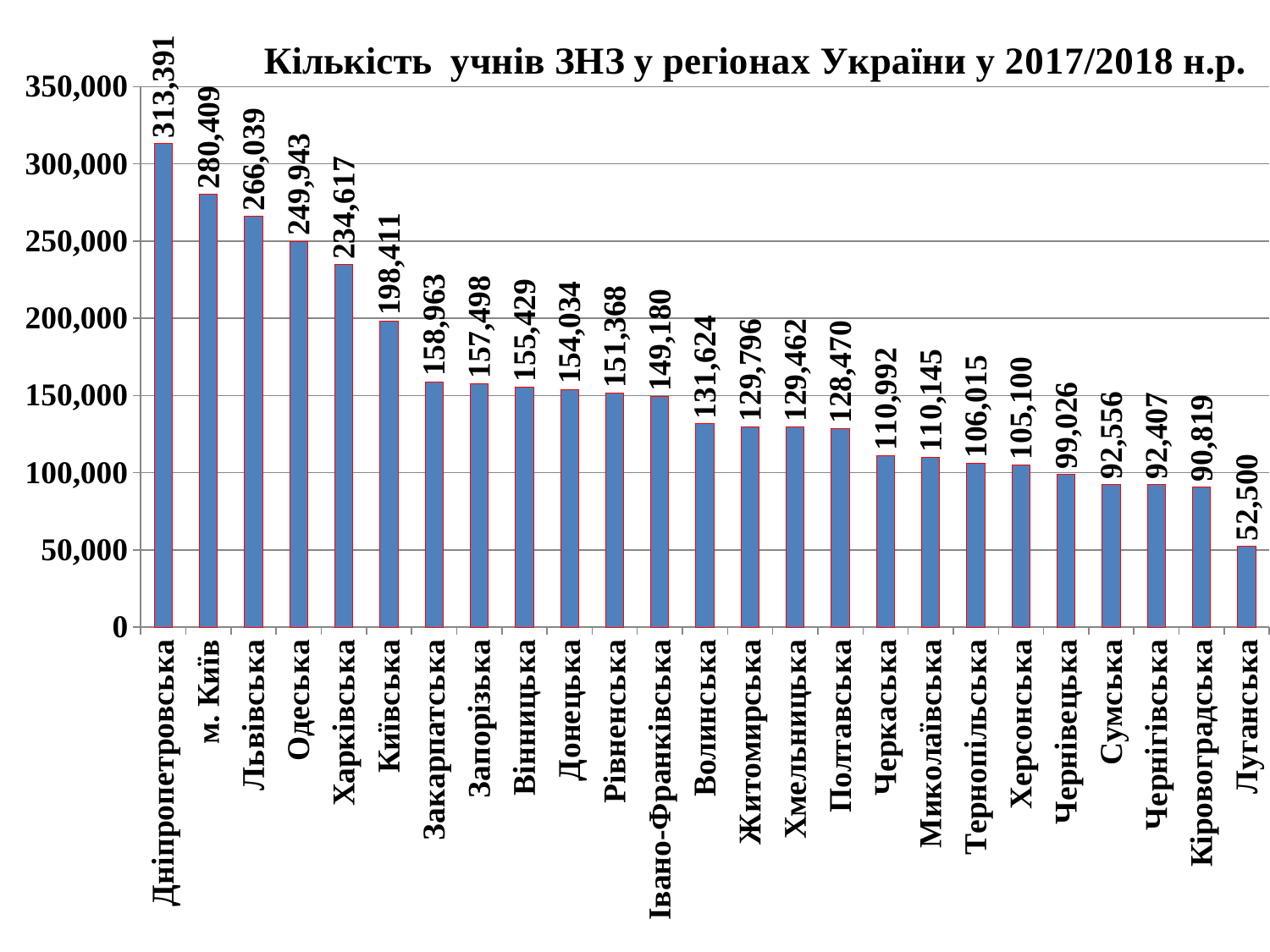
How many regions are shown on the chart? 25 Do the values rise or fall from left to right along the x axis? Fall What is the value for м. Київ? 280,409 What is the value for Луганська? 52,500 What kind of chart is this? Bar chart What is the difference between the values for Дніпропетровська and Луганська? 260,891 What is the value for Дніпропетровська? 313,391 Which is larger, the value for Одеська or the value for Харківська? Одеська What is the value for Полтавська? 128,470 Which region has the highest value? Дніпропетровська Which region has the lowest value? Луганська What is the difference between the values for м. Київ and Львівська? 14,370